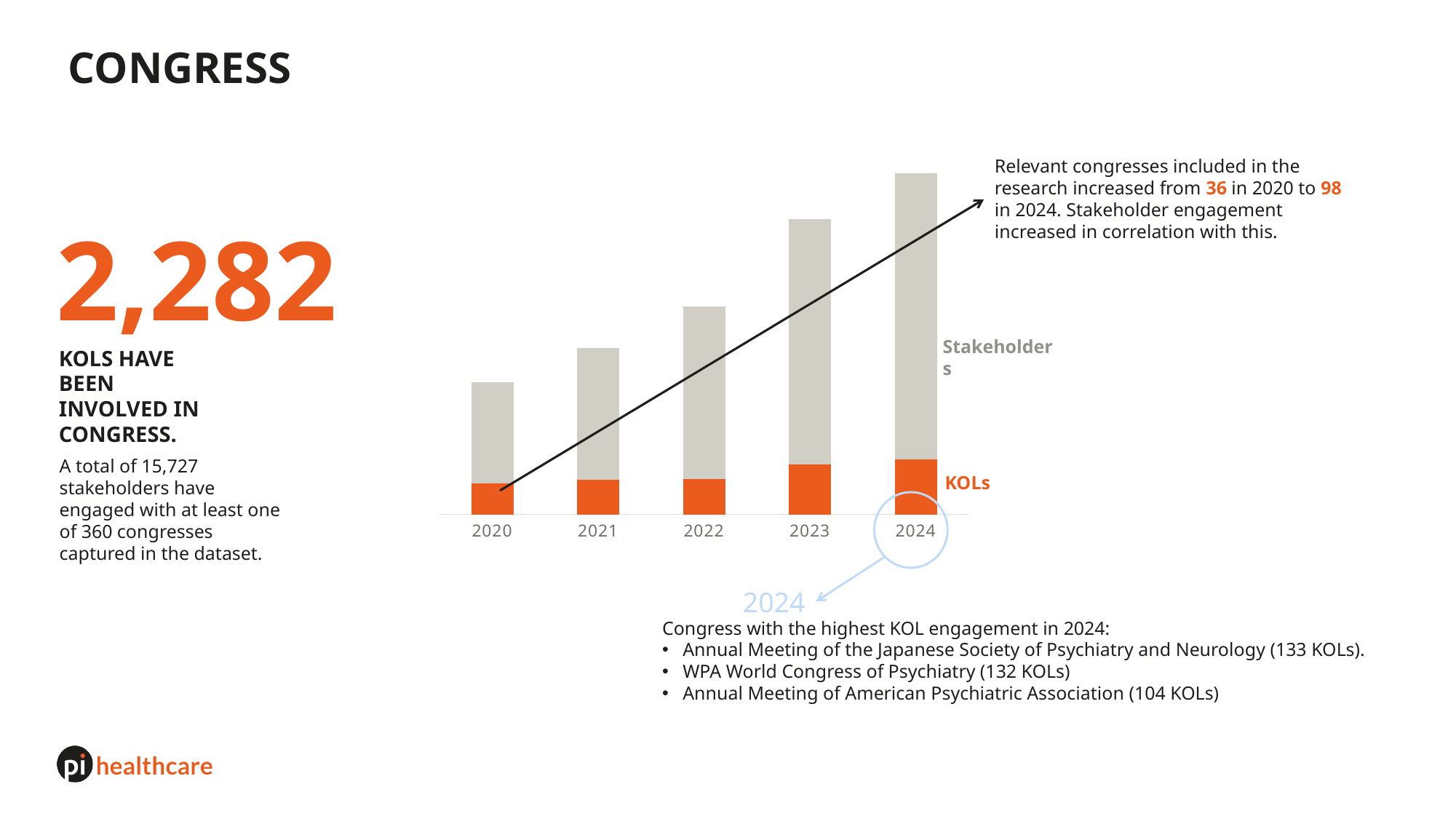
What is the last year shown on the x axis of the chart? 2024 How many years are shown along the x axis of the chart? 5 Which year has the larger total bar, 2021 or 2023? 2023 How many series does the chart show? 2 Which series is shown in orange in the chart? KOLs What is the first year shown on the x axis of the chart? 2020 Which year has the tallest bar in the chart? 2024 Do the bar heights rise or fall from 2020 to 2024? Rise Which year has the shortest bar in the chart? 2020 Which series is shown in grey in the chart? Stakeholders Which year has the larger KOLs segment, 2020 or 2024? 2024 What kind of chart is shown on the slide? Stacked bar chart